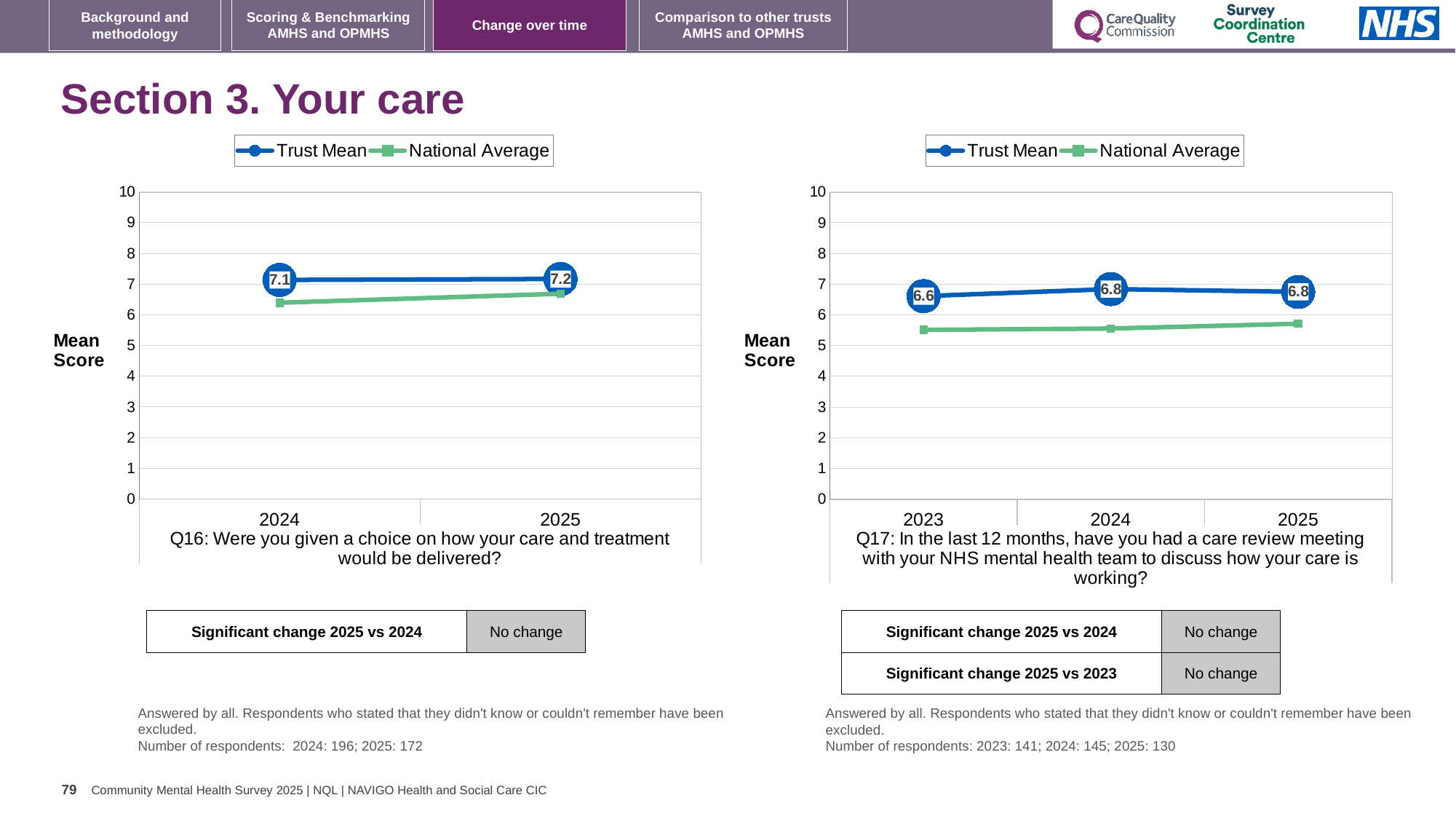
In the Q16 chart on the left, what is the difference between the Trust Mean for 2025 and 2024? 0.1 In the Q17 chart on the right, what is the difference between the Trust Mean for 2024 and 2023? 0.2 How many years are plotted on the x axis of the Q17 chart on the right? 3 How many series does the legend of the Q16 chart on the left list? 2 In the Q16 chart on the left, what is the Trust Mean for 2025? 7.2 In the Q17 chart on the right, is the National Average for 2023 greater or less than 6? less In the Q17 chart on the right, which year has the lowest Trust Mean? 2023 In the Q16 chart on the left, is the National Average for 2024 greater or less than 7? less In the Q17 chart on the right, which is larger in 2025, the Trust Mean or the National Average? Trust Mean In the Q16 chart on the left, what is the Trust Mean for 2024? 7.1 In the Q17 chart on the right, what is the Trust Mean for 2025? 6.8 In the Q17 chart on the right, what is the Trust Mean for 2023? 6.6